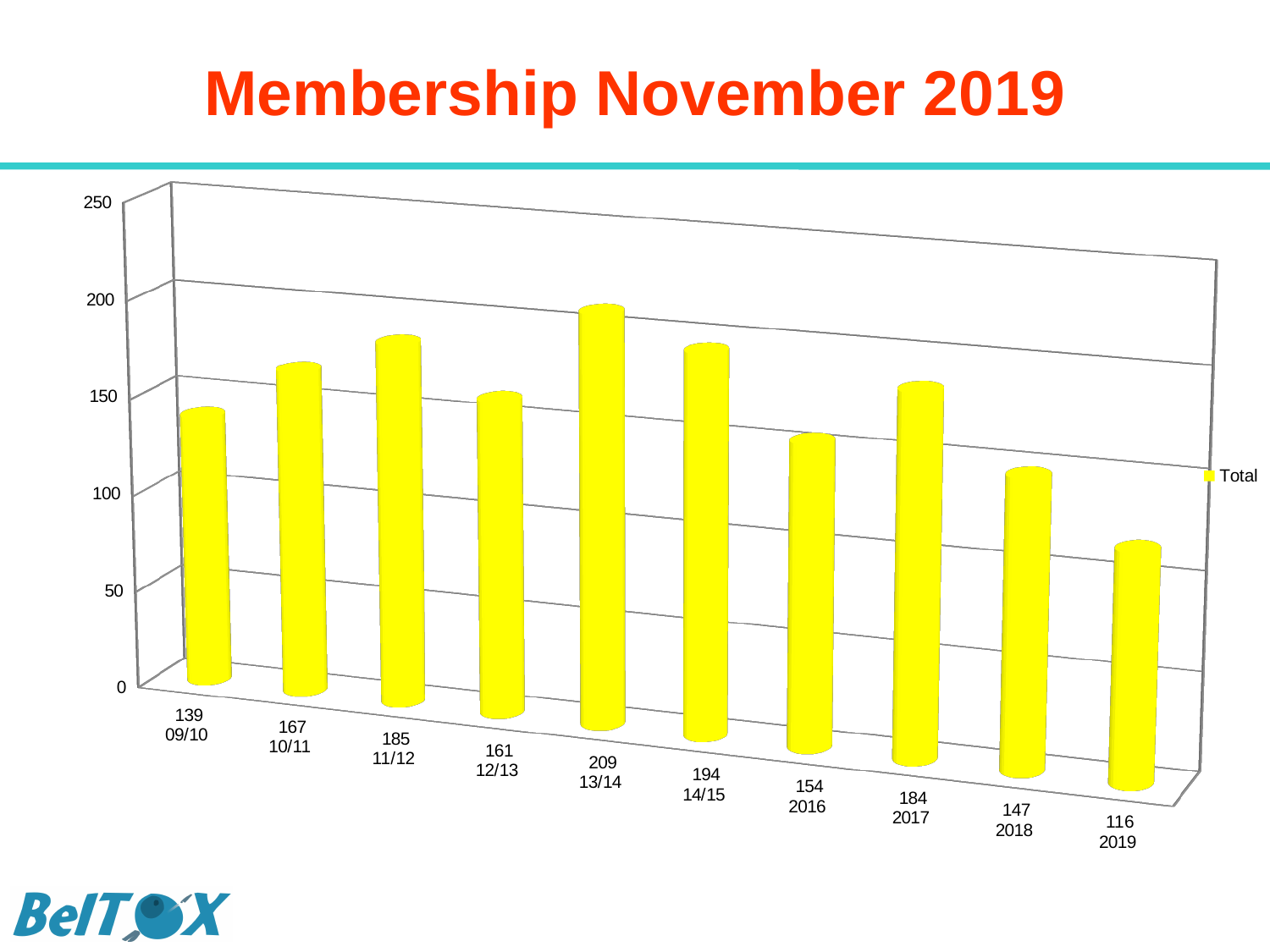
What is the membership total for 13/14? 209 How many periods are shown on the chart? 10 Which period has the highest membership total? 13/14 What is the difference between the membership totals for 2017 and 2018? 37 Which period has the lowest membership total? 2019 Which is larger, the membership total for 10/11 or for 2016? 10/11 Is the membership total for 14/15 greater or less than 150? greater What is the membership total for 2019? 116 What is the membership total for 11/12? 185 What is the difference between the membership totals for 13/14 and 2019? 93 What kind of chart is shown on the slide? bar chart What is the only series listed in the chart legend? Total